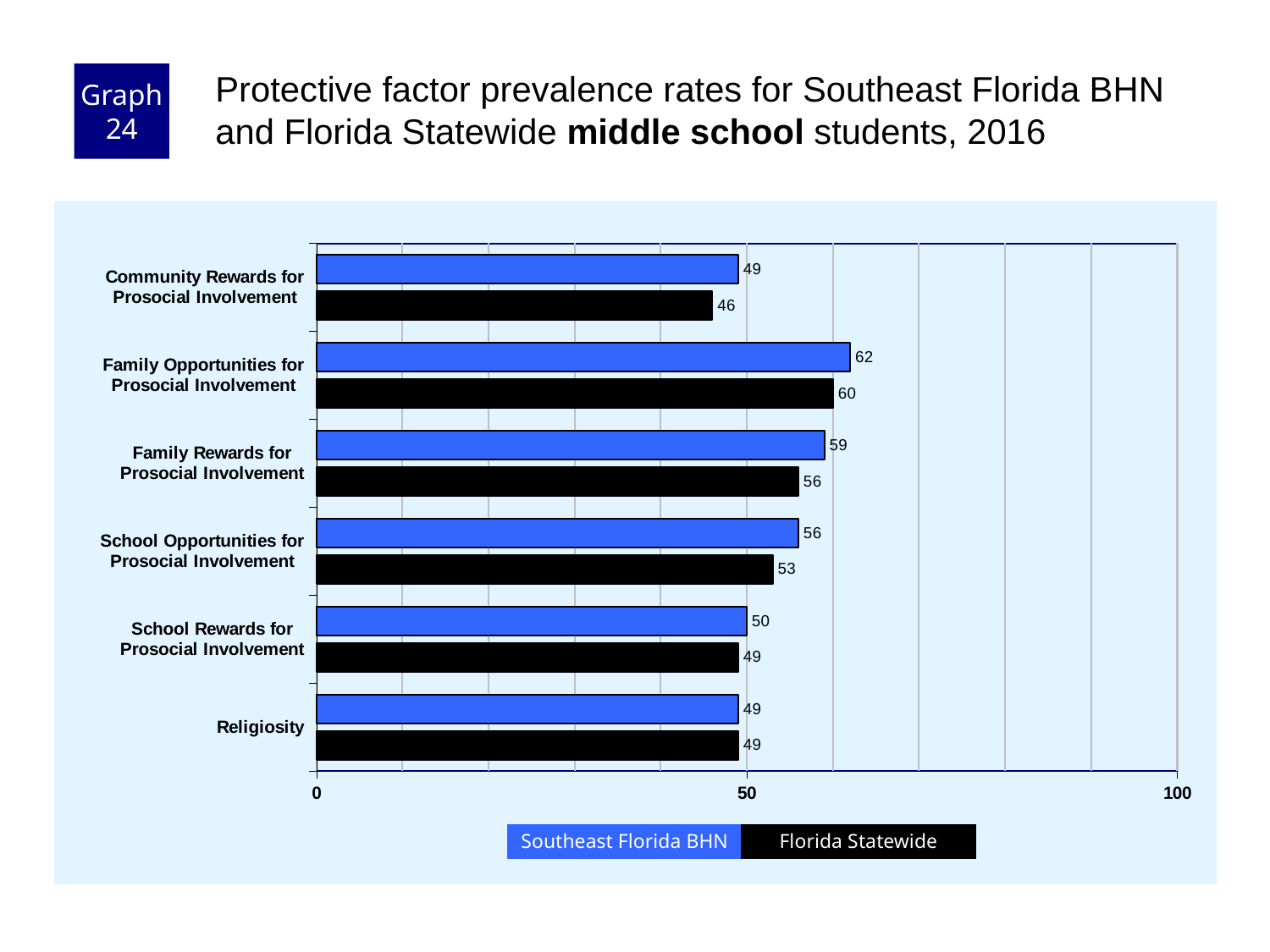
What is the Florida Statewide value for School Opportunities for Prosocial Involvement? 53 Which is larger for School Opportunities for Prosocial Involvement: the Southeast Florida BHN value or the Florida Statewide value? Southeast Florida BHN How many series does the legend list? 2 What is the Southeast Florida BHN value for Family Opportunities for Prosocial Involvement? 62 Which category has the lowest Florida Statewide value? Community Rewards for Prosocial Involvement How many protective factor categories are shown on the chart? 6 Is the Southeast Florida BHN value for Family Opportunities for Prosocial Involvement greater or less than 50? greater What kind of chart is shown on the slide? bar chart Which colour represents Florida Statewide in the chart? black What is the difference between the Southeast Florida BHN and Florida Statewide values for Family Rewards for Prosocial Involvement? 3 Which category has the highest Southeast Florida BHN value? Family Opportunities for Prosocial Involvement What is the Florida Statewide value for Community Rewards for Prosocial Involvement? 46